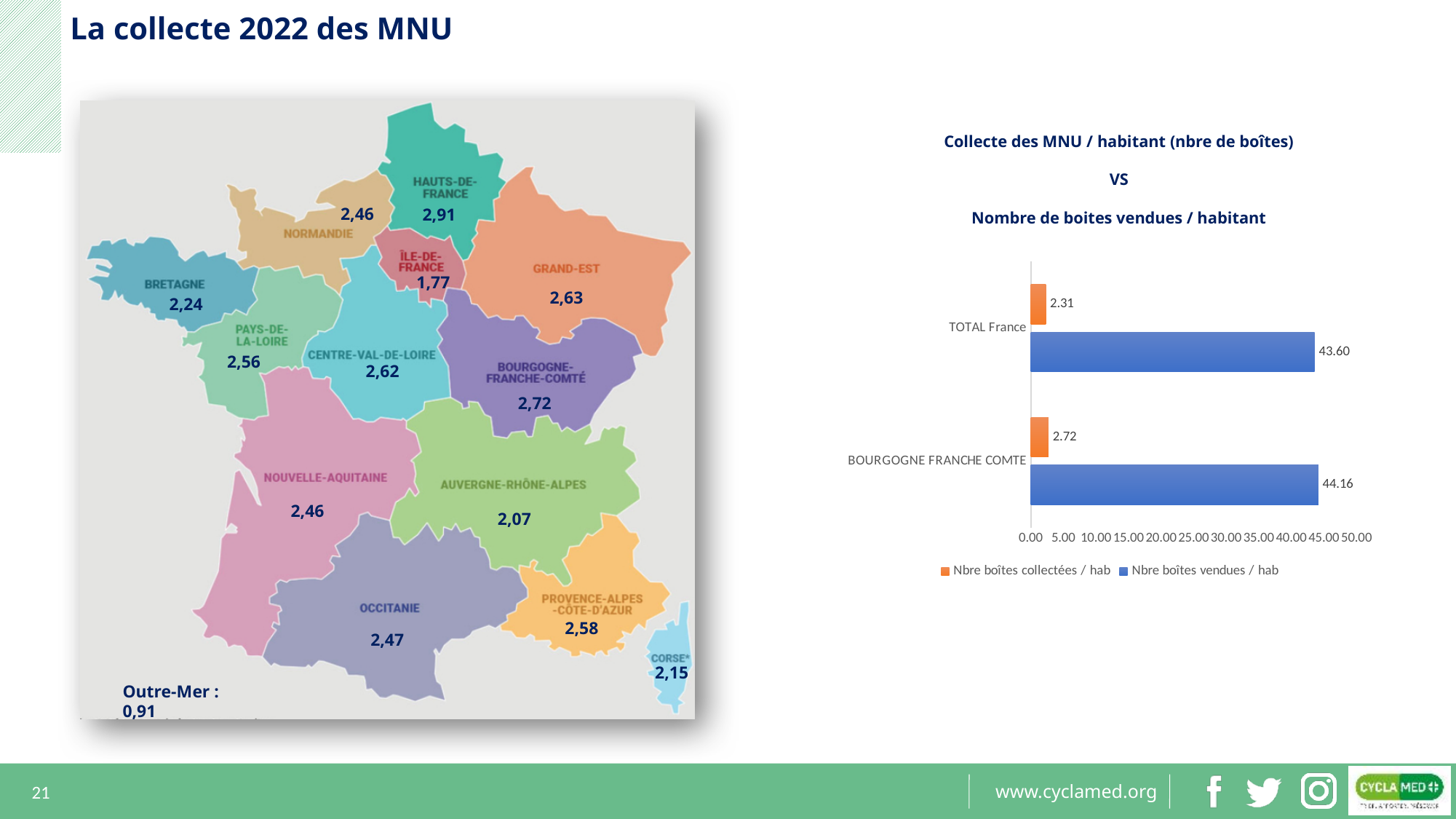
In the bar chart on the right, what is the value of 'Nbre boîtes vendues / hab' for BOURGOGNE FRANCHE COMTE? 44.16 In the bar chart on the right, how many series does the legend list? 2 What kind of chart is shown on the right side of the slide? bar chart In the bar chart on the right, is the 'Nbre boîtes vendues / hab' value for TOTAL France greater or less than 40.00? greater In the bar chart on the right, what is the difference between the 'Nbre boîtes vendues / hab' values for BOURGOGNE FRANCHE COMTE and TOTAL France? 0.56 In the bar chart on the right, which colour represents the series 'Nbre boîtes collectées / hab'? orange On the map on the left, which region has the highest printed collection value? Hauts-de-France (2,91) In the bar chart on the right, how many categories are plotted? 2 In the bar chart on the right, which category has the higher 'Nbre boîtes collectées / hab' value, TOTAL France or BOURGOGNE FRANCHE COMTE? BOURGOGNE FRANCHE COMTE In the bar chart on the right, what is the value of 'Nbre boîtes collectées / hab' for TOTAL France? 2.31 In the bar chart on the right, what is the difference between the 'Nbre boîtes collectées / hab' values for BOURGOGNE FRANCHE COMTE and TOTAL France? 0.41 In the bar chart on the right, what is the value of 'Nbre boîtes vendues / hab' for TOTAL France? 43.60